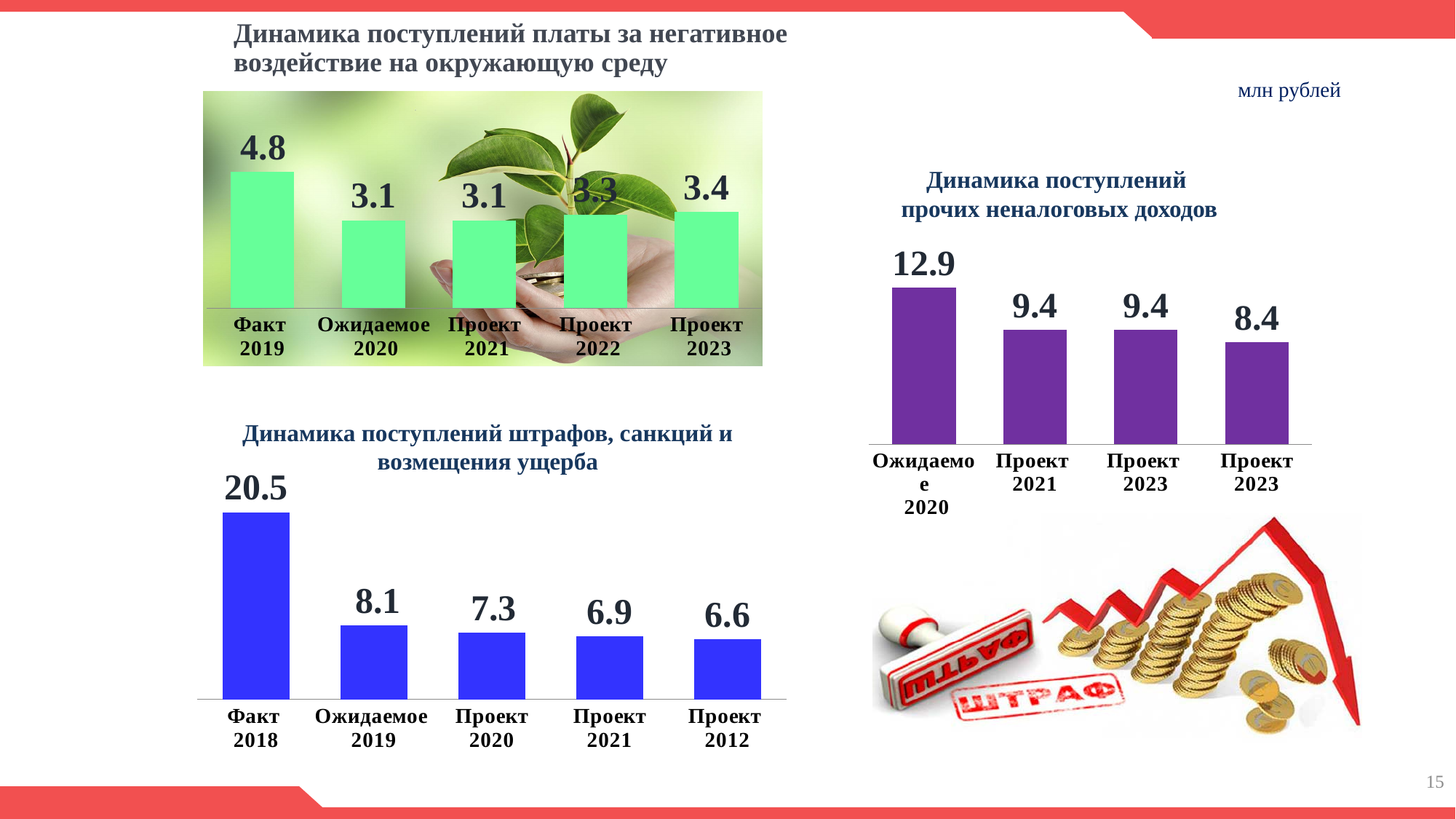
In the chart 'Динамика поступлений платы за негативное воздействие на окружающую среду', how many bars are plotted? 5 In the chart 'Динамика поступлений прочих неналоговых доходов', what is the value for Ожидаемое 2020? 12.9 In the chart 'Динамика поступлений штрафов, санкций и возмещения ущерба', which category has the lowest value? Проект 2012 In the chart 'Динамика поступлений штрафов, санкций и возмещения ущерба', what is the difference between Факт 2018 and Проект 2020? 13.2 In the chart 'Динамика поступлений платы за негативное воздействие на окружающую среду', what is the value for Факт 2019? 4.8 In the chart 'Динамика поступлений штрафов, санкций и возмещения ущерба', do the values rise or fall from left to right? fall In the chart 'Динамика поступлений штрафов, санкций и возмещения ущерба', what is the value for Ожидаемое 2019? 8.1 In the chart 'Динамика поступлений платы за негативное воздействие на окружающую среду', what is the difference between Факт 2019 and Проект 2023? 1.4 What type of chart is 'Динамика поступлений прочих неналоговых доходов'? bar chart In the chart 'Динамика поступлений платы за негативное воздействие на окружающую среду', which category has the highest value? Факт 2019 In the chart 'Динамика поступлений прочих неналоговых доходов', which is larger: Ожидаемое 2020 or Проект 2021? Ожидаемое 2020 In the chart 'Динамика поступлений прочих неналоговых доходов', what is the value of the rightmost bar? 8.4